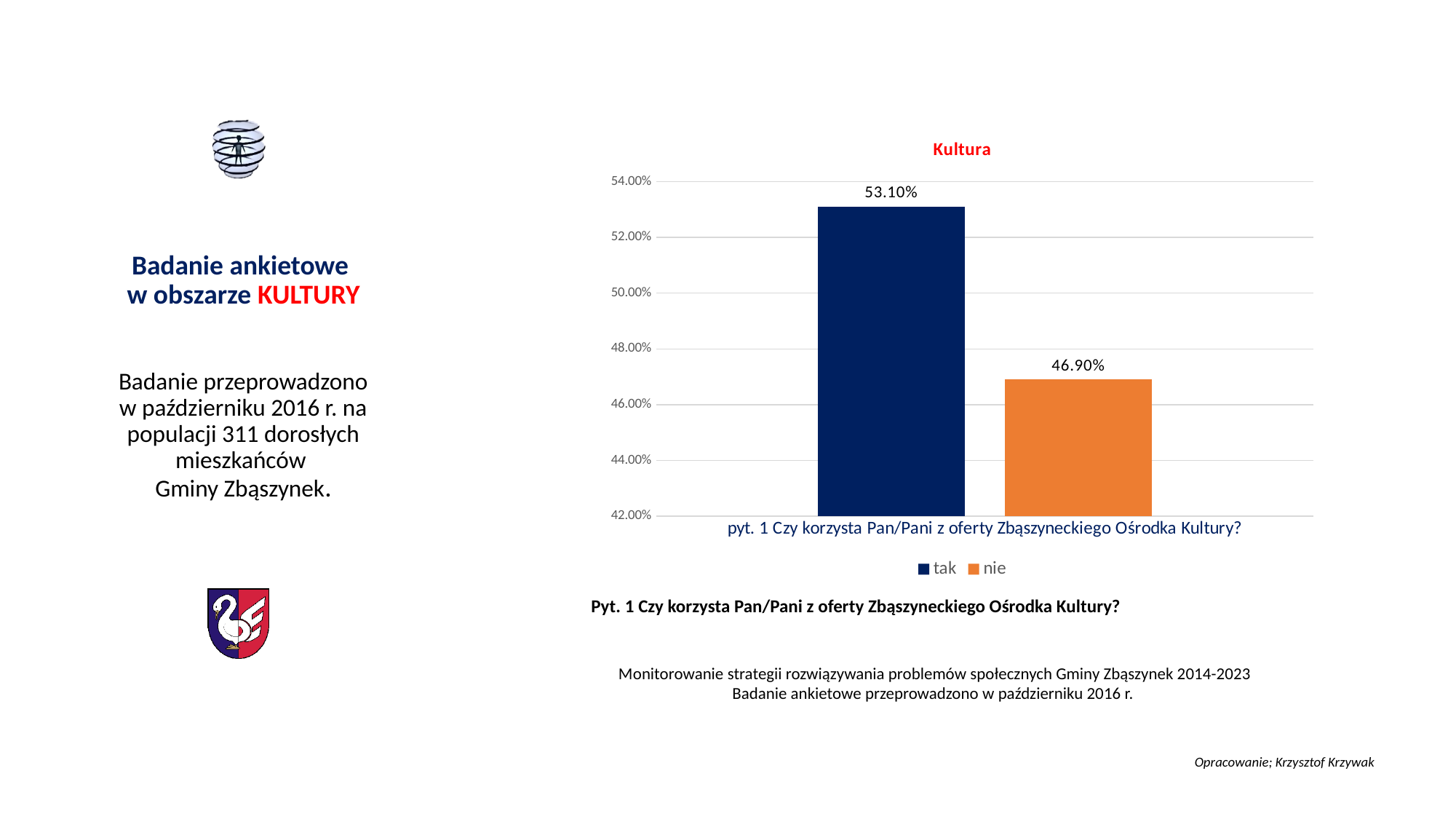
What kind of chart is shown on the slide? bar chart What is the difference between the values for "tak" and "nie"? 6.20% How many series does the legend list? 2 Which series has the lowest value in the chart? nie How many bars are plotted in the chart? 2 Is the value for "tak" greater or less than 52.00%? greater Which series has the higher value, "tak" or "nie"? tak What is the value for "nie" in the chart? 46.90% What colour is the bar for "nie"? orange What is the value for "tak" in the chart? 53.10% Is the value for "nie" greater or less than 48.00%? less What is the title of the chart? Kultura